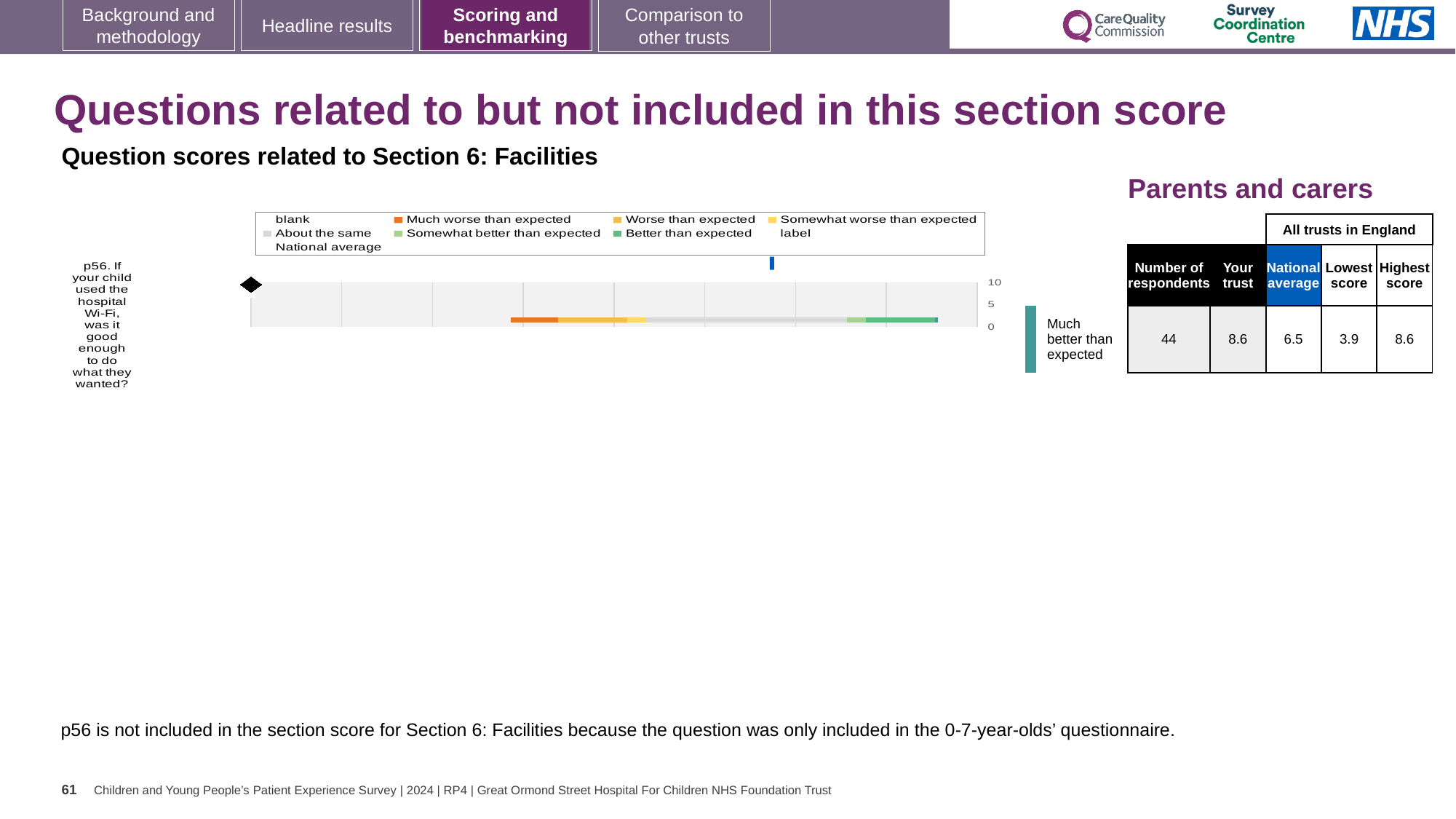
How many survey questions are plotted in the chart? 1 What rating category is shown next to the chart for p56? Much better than expected Which survey question is plotted in the chart? p56. If your child used the hospital Wi-Fi, was it good enough to do what they wanted? What is the difference between the 'Your trust' score and the national average for p56? 2.1 What is the difference between the highest and lowest scores for p56? 4.7 What is the lowest score among all trusts in England for p56? 3.9 Which is larger for p56, the 'Your trust' score or the national average? Your trust What is the national average score for p56? 6.5 What kind of chart is shown on the slide? bar chart What is the 'Your trust' score for p56? 8.6 What is the highest score among all trusts in England for p56? 8.6 How many respondents answered p56? 44